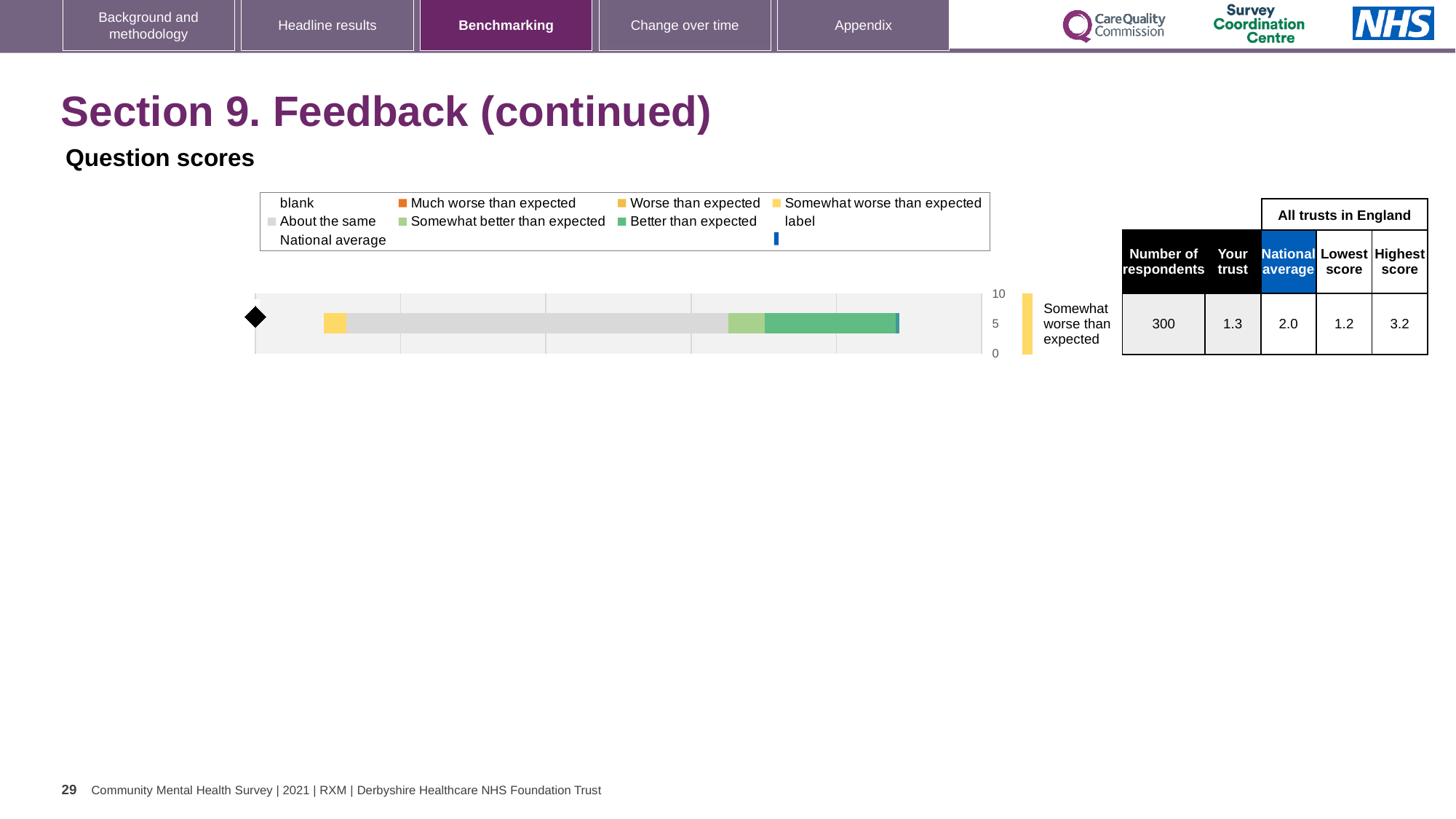
What is the national average score shown in the table next to the chart? 2.0 What is the 'Your trust' score shown in the table next to the chart? 1.3 What is the highest score among all trusts in England shown in the table? 3.2 What is the difference between the national average and the 'Your trust' score? 0.7 What is the lowest score among all trusts in England shown in the table? 1.2 What colour is the 'About the same' segment in the chart's legend? grey How many respondents are shown in the table next to the chart? 300 What rating label is shown next to the bar in the chart? Somewhat worse than expected Which is larger, the 'Your trust' score or the national average? National average What kind of chart is shown on the slide? bar chart How many bars are plotted in the chart? 1 What is the difference between the highest score and the lowest score in the table? 2.0